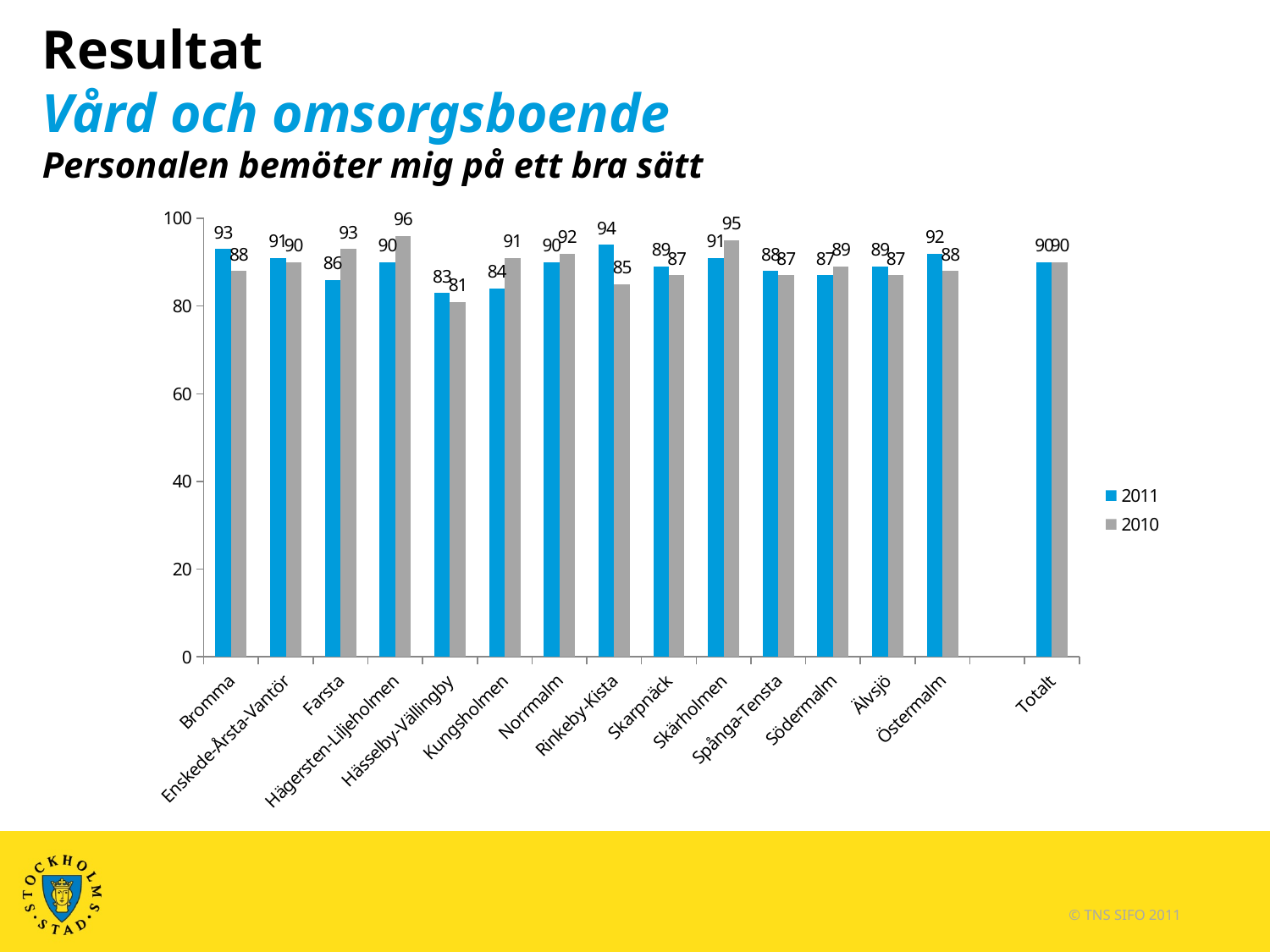
For Farsta, which is larger: the 2011 value or the 2010 value? 2010 What is the 2011 value for Rinkeby-Kista? 94 Which category has the lowest 2010 value? Hässelby-Vällingby How many series does the legend list? 2 What is the 2011 value for Hässelby-Vällingby? 83 What is the 2010 value for Hägersten-Liljeholmen? 96 What is the difference between the 2011 and 2010 values for Rinkeby-Kista? 9 Which category has the highest 2011 value? Rinkeby-Kista What is the difference between the 2010 and 2011 values for Kungsholmen? 7 What kind of chart is shown on the slide? Bar chart Is the 2011 value for Bromma greater or less than 80? greater How many categories are shown on the x axis? 15